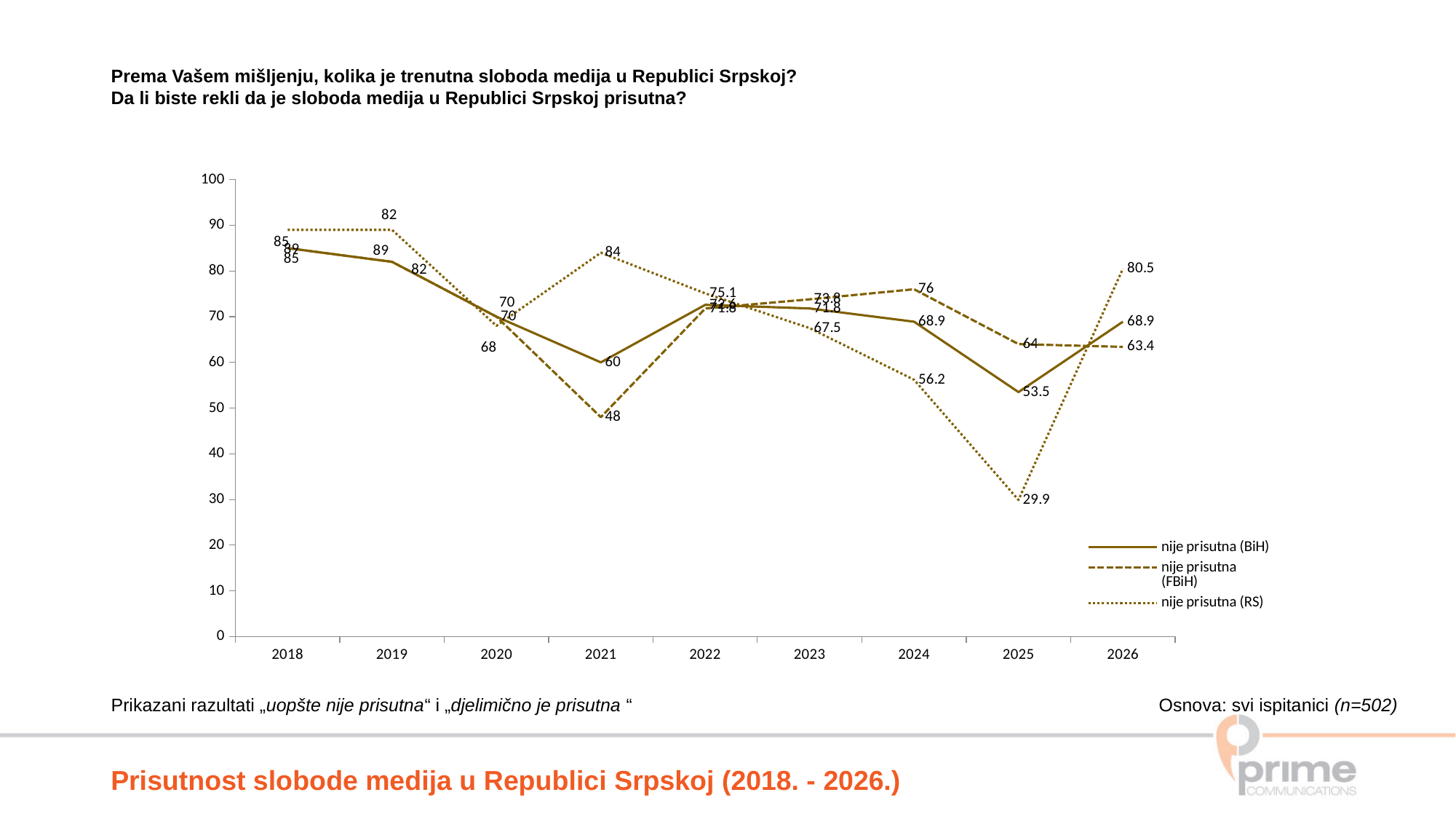
What is the value for 'nije prisutna (BiH)' in 2026? 68.9 What kind of chart is shown on the slide? line chart What is the value for 'nije prisutna (FBiH)' in 2021? 48 How many years are shown on the x axis? 9 In which year is the 'nije prisutna (RS)' series at its lowest? 2025 In which year is the 'nije prisutna (FBiH)' series at its lowest? 2021 What is the value for 'nije prisutna (RS)' in 2025? 29.9 What is the value for 'nije prisutna (BiH)' in 2021? 60 What is the value for 'nije prisutna (RS)' in 2026? 80.5 How many series does the legend list? 3 What is the difference between 'nije prisutna (FBiH)' and 'nije prisutna (BiH)' in 2024? 7.1 In 2025, which is larger: 'nije prisutna (FBiH)' or 'nije prisutna (BiH)'? nije prisutna (FBiH)